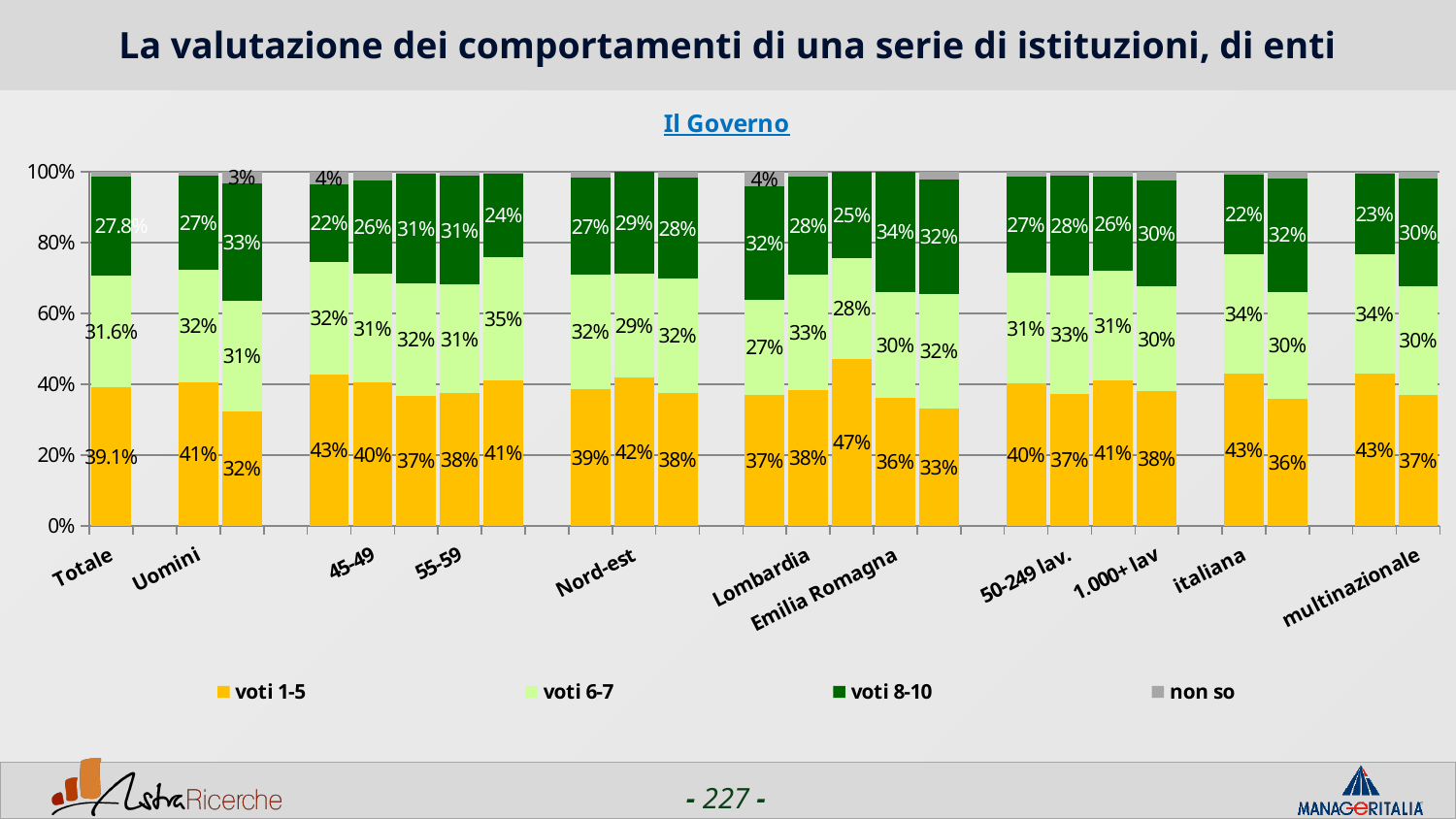
What is the value of 'voti 1-5' for Uomini? 41% Which is larger for Uomini: 'voti 1-5' or 'voti 6-7'? voti 1-5 What is the value of 'voti 6-7' for Totale? 31.6% What kind of chart is shown on the slide? stacked bar chart How many series does the legend list? 4 What is the value of 'voti 8-10' for Uomini? 27% What is the value of 'voti 8-10' for Totale? 27.8% What is the title of the chart? Il Governo What is the total of the three labelled segments (voti 1-5, voti 6-7, voti 8-10) for Totale? 98.5% What is the difference between 'voti 1-5' and 'voti 8-10' for Uomini? 14% What is the value of 'voti 1-5' for Totale? 39.1% Which legend entry is shown in dark green? voti 8-10